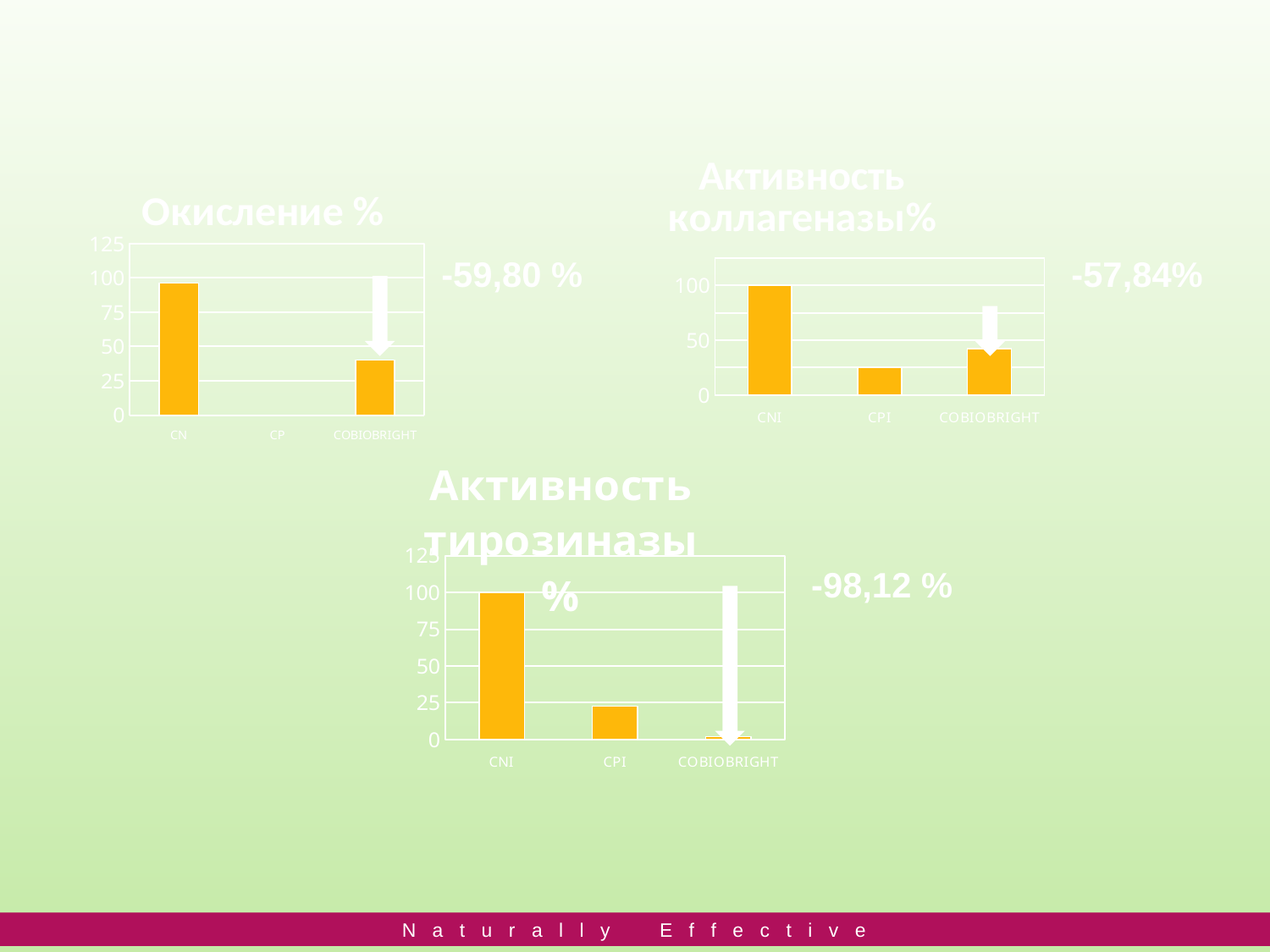
In the 'Окисление %' chart, is the value for CN greater or less than 75? greater What percentage change is printed next to the 'Активность тирозиназы %' chart? -98,12 % In the 'Окисление %' chart, is the value for COBIOBRIGHT greater or less than 50? less In the 'Активность коллагеназы%' chart, is the value for COBIOBRIGHT greater or less than 50? less What percentage change is printed next to the 'Окисление %' chart? -59,80 % How many categories are shown on the x axis of the 'Окисление %' chart? 3 In the 'Активность коллагеназы%' chart, which is larger, CNI or COBIOBRIGHT? CNI In the 'Активность тирозиназы %' chart, which category has the lowest bar? COBIOBRIGHT In the 'Активность коллагеназы%' chart, which category has the lowest bar? CPI What kind of chart is the 'Окисление %' chart? bar chart In the 'Окисление %' chart, which category has the highest bar? CN